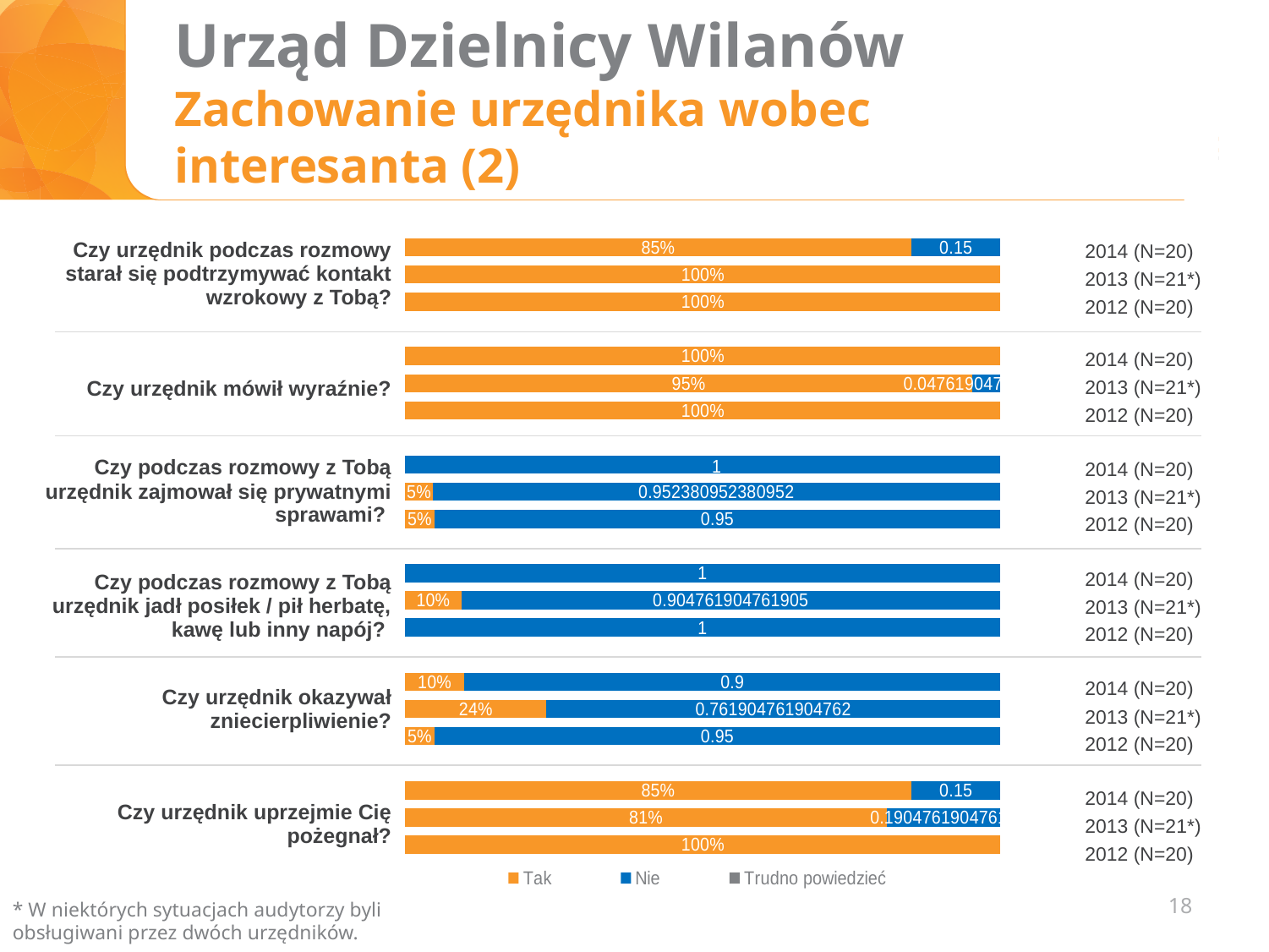
For the question 'Czy urzędnik okazywał zniecierpliwienie?', which year has the highest 'Tak' share? 2013 (N=21*) What is the 'Tak' value for 2014 (N=20) for the question 'Czy urzędnik podczas rozmowy starał się podtrzymywać kontakt wzrokowy z Tobą?' 85% What is the 'Tak' value for 2013 (N=21*) for the question 'Czy urzędnik uprzejmie Cię pożegnał?' 81% For the question 'Czy podczas rozmowy z Tobą urzędnik jadł posiłek / pił herbatę, kawę lub inny napój?', is the 'Tak' value for 2013 (N=21*) larger or smaller than the 'Tak' value for 2012 (N=20)? larger What type of chart is shown on the slide? Stacked bar chart What is the 'Nie' value for 2013 (N=21*) for the question 'Czy urzędnik mówił wyraźnie?' 0.047619047 What is the 'Tak' value for 2013 (N=21*) for the question 'Czy urzędnik okazywał zniecierpliwienie?' 24% What are the legend entries of the chart? Tak, Nie, Trudno powiedzieć What is the 'Nie' value for 2014 (N=20) for the question 'Czy urzędnik okazywał zniecierpliwienie?' 0.9 For the question 'Czy urzędnik okazywał zniecierpliwienie?', which year has the lowest 'Tak' share? 2012 (N=20) How many series does the legend list? 3 For the question 'Czy urzędnik uprzejmie Cię pożegnał?', what is the difference in percentage points between the 'Tak' value for 2014 (N=20) and 2013 (N=21*)? 4